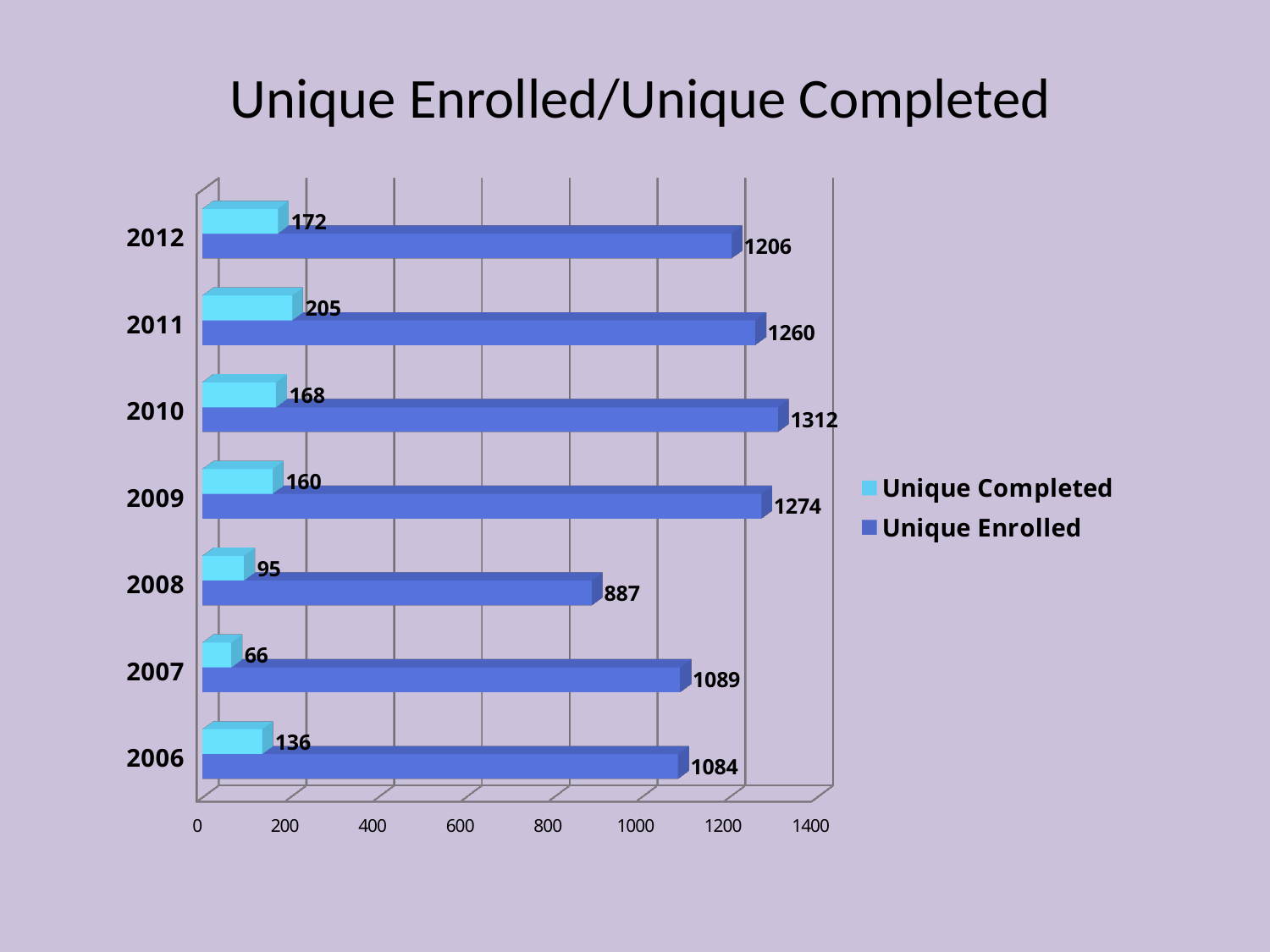
What is the Unique Completed value for 2011? 205 What is the Unique Enrolled value for 2010? 1312 What is the Unique Completed value for 2007? 66 Which year has the lowest Unique Completed value? 2007 What is the difference between Unique Enrolled and Unique Completed in 2012? 1034 Which year has the lowest Unique Enrolled value? 2008 What kind of chart is shown on the slide? Bar chart Which is larger, the Unique Enrolled value for 2011 or for 2009? 2009 Which year has the highest Unique Enrolled value? 2010 How many series does the legend list? 2 How many years are shown on the chart? 7 What is the title of the chart? Unique Enrolled/Unique Completed